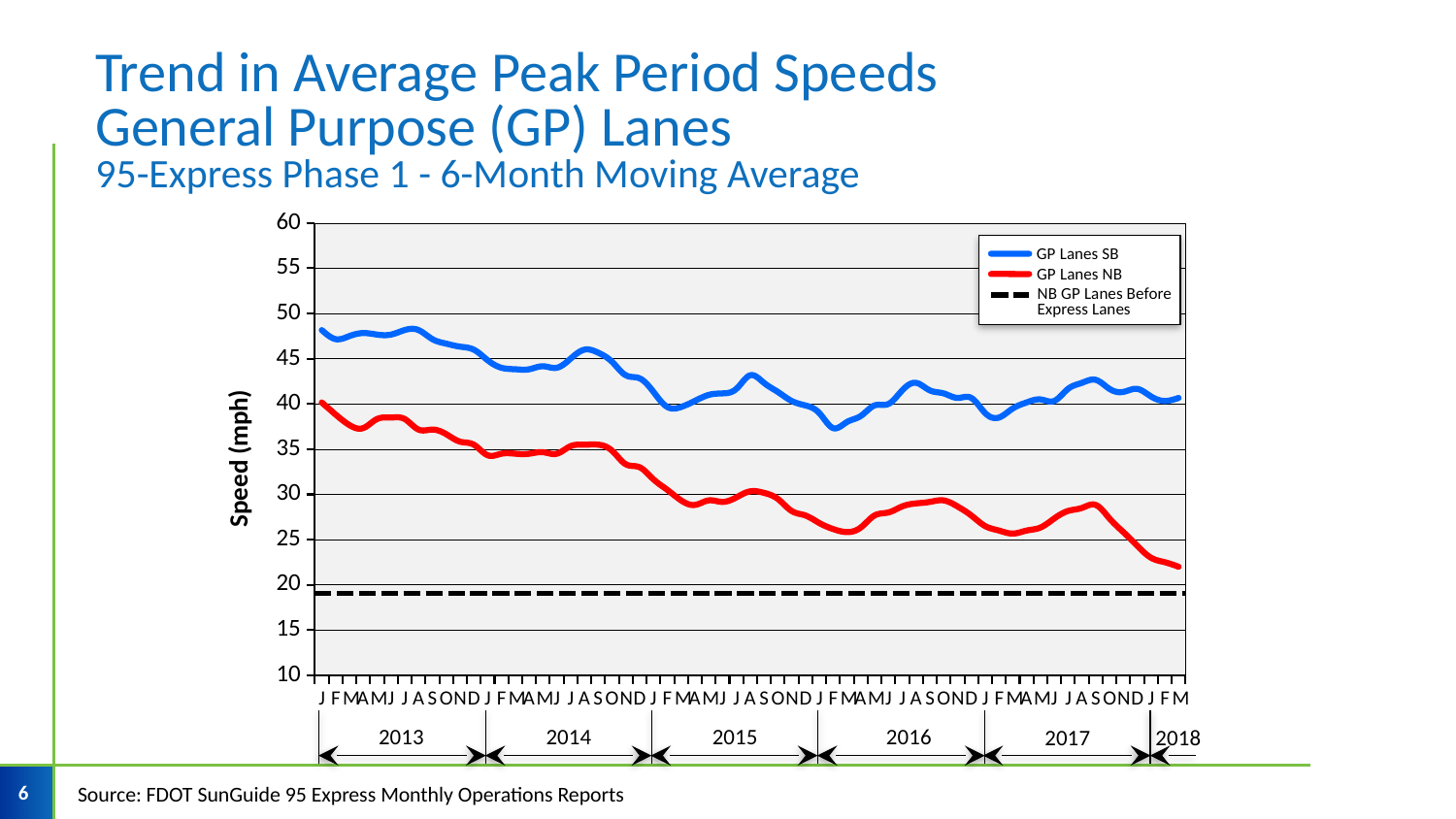
Is the value for GP Lanes SB in January 2013 greater or less than 45? greater Is the value for GP Lanes SB in early 2016 greater or less than 40? less Does the GP Lanes NB series generally rise or fall from 2013 to 2018? Fall How many years are labeled along the x axis? 6 Which series has higher speeds throughout the period, GP Lanes SB or GP Lanes NB? GP Lanes SB What is the label on the vertical axis of the chart? Speed (mph) How many series does the legend list? 3 Is the value for GP Lanes NB in January 2013 greater or less than 35? greater What kind of chart is shown on the slide? Line chart Which series is drawn as a dashed black line? NB GP Lanes Before Express Lanes